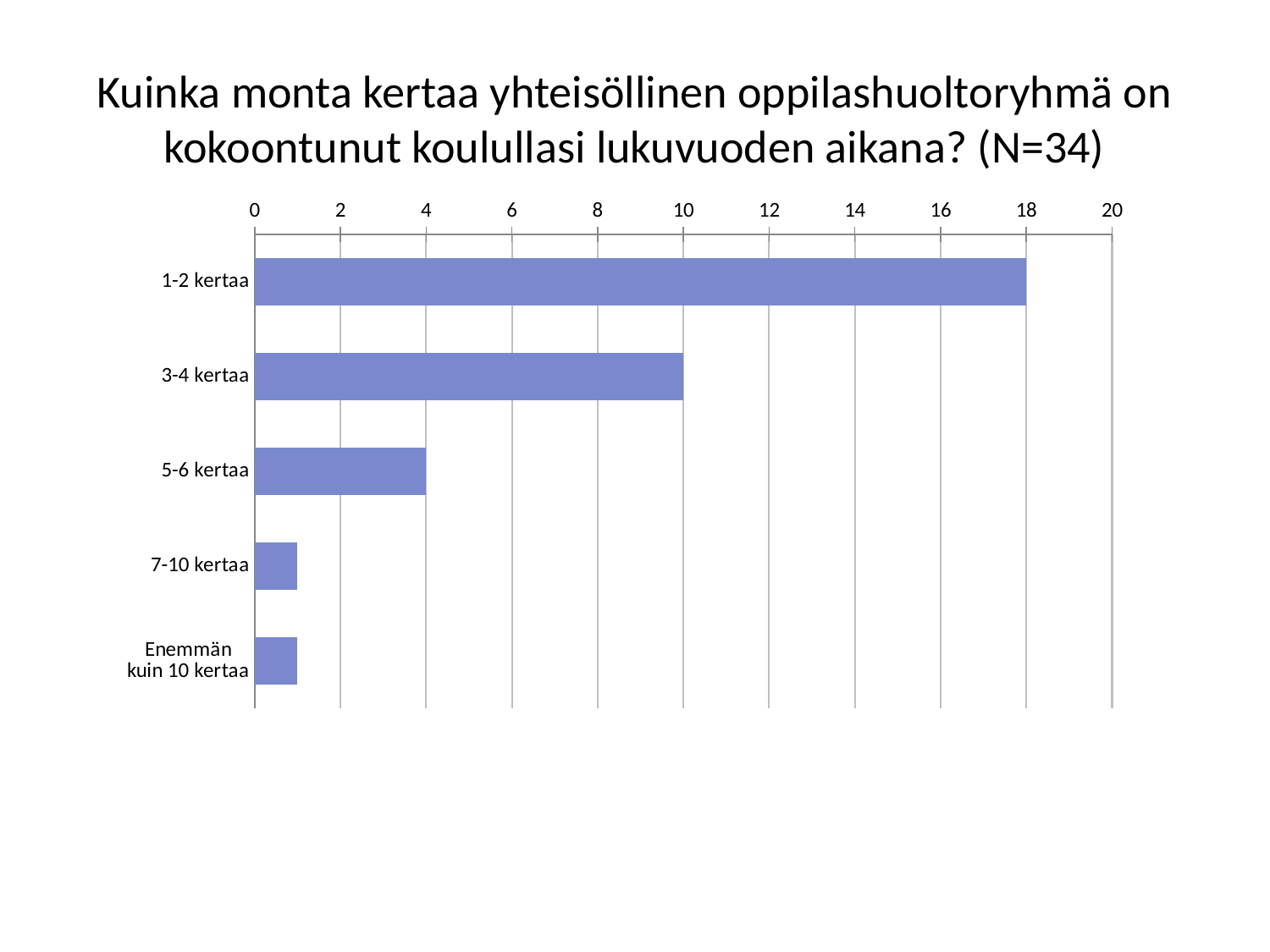
What is the value for "1-2 kertaa"? 18 What kind of chart is shown on the slide? bar chart Is the value for "Enemmän kuin 10 kertaa" greater or less than 2? less What is the N value given in the chart title? N=34 What is the value for "3-4 kertaa"? 10 Which category has the highest value? 1-2 kertaa What is the difference between the values for "3-4 kertaa" and "5-6 kertaa"? 6 Which is larger, the value for "3-4 kertaa" or the value for "5-6 kertaa"? 3-4 kertaa Is the value for "7-10 kertaa" greater or less than 2? less What is the value for "5-6 kertaa"? 4 What is the difference between the values for "1-2 kertaa" and "3-4 kertaa"? 8 How many categories are shown on the chart? 5